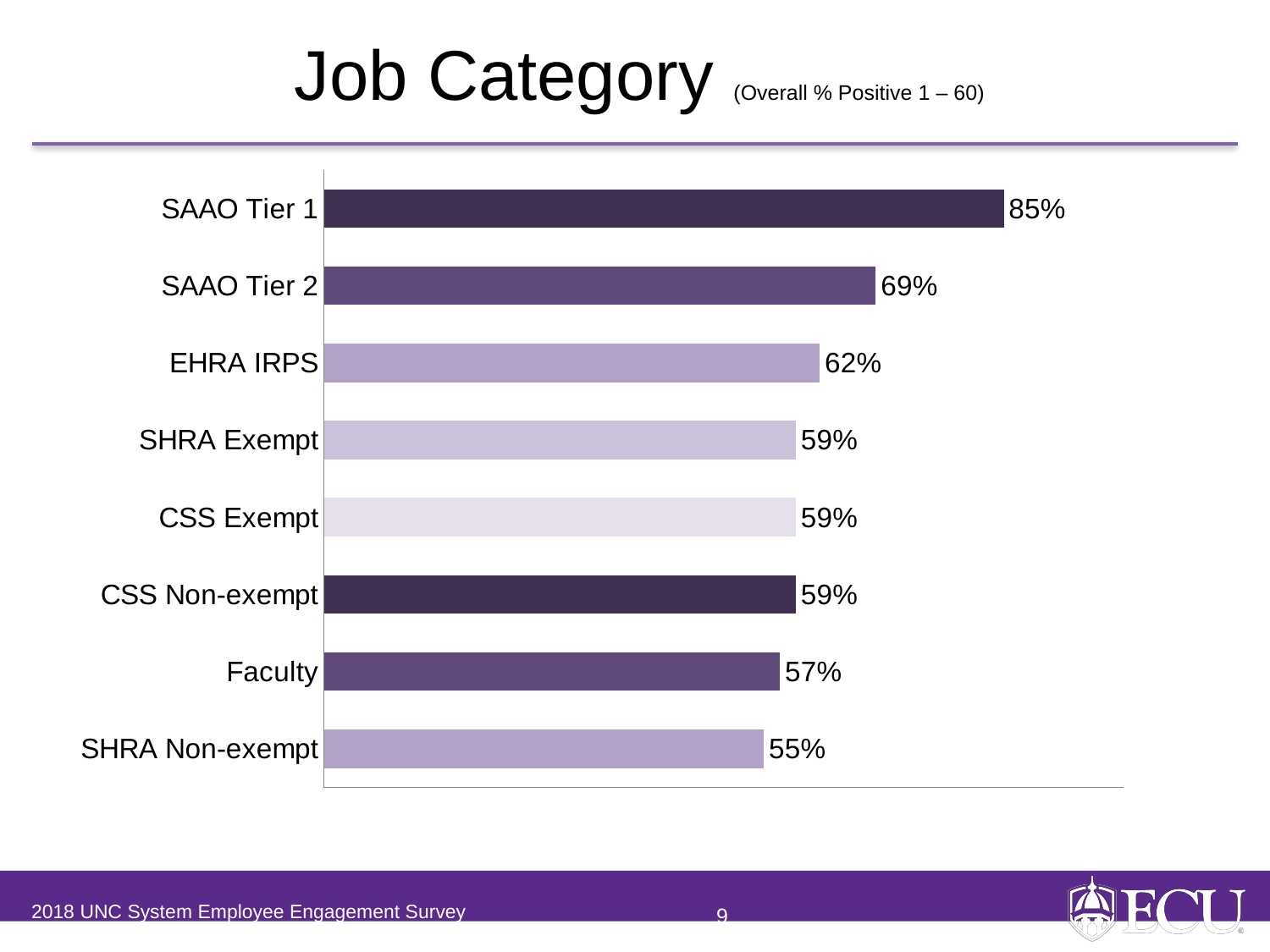
What is the value for SAAO Tier 1? 85% What kind of chart is shown on the slide? Bar chart What is the title of the chart on the slide? Job Category What is the difference between the values for SAAO Tier 1 and SAAO Tier 2? 16% What is the difference between the values for EHRA IRPS and SHRA Non-exempt? 7% What is the value for EHRA IRPS? 62% Which job category has the highest value? SAAO Tier 1 What is the value for Faculty? 57% How many job categories are shown in the chart? 8 What is the value for SHRA Non-exempt? 55% Which is larger, the value for SAAO Tier 2 or the value for Faculty? SAAO Tier 2 Which job category has the lowest value? SHRA Non-exempt